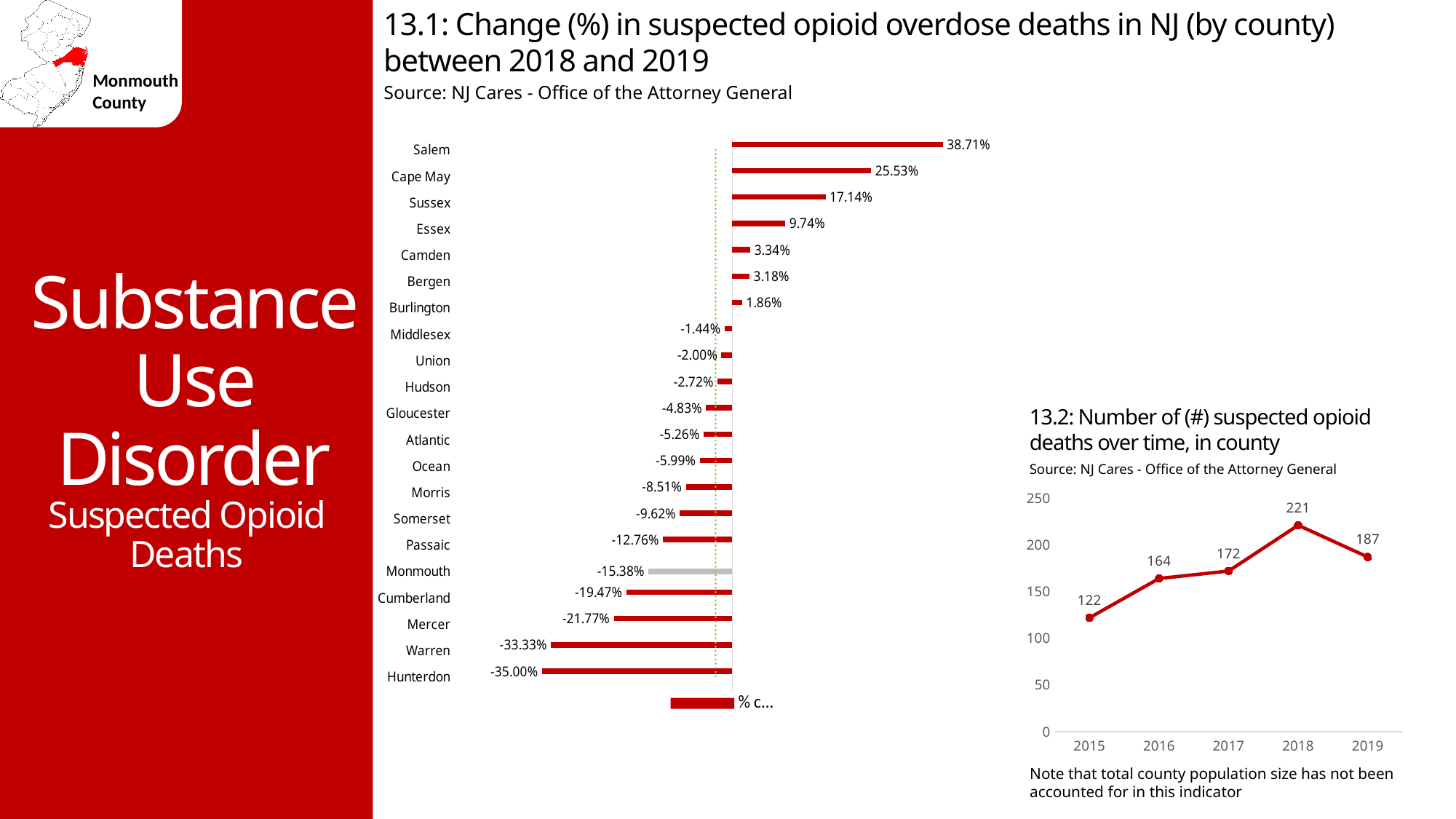
In chart 13.1, how many counties are shown? 21 In chart 13.1, which is larger, the value for Essex or the value for Camden? Essex What kind of chart is chart 13.1? Bar chart In chart 13.2, which year has the lowest number of suspected opioid deaths? 2015 In chart 13.1, which county has the highest percentage change? Salem In chart 13.1, what is the value for Cape May? 25.53% In chart 13.1 (Change (%) in suspected opioid overdose deaths in NJ by county), what is the value for Monmouth? -15.38% In chart 13.2, what is the difference between the values for 2018 and 2019? 34 In chart 13.1, what is the difference between the values for Salem and Cape May? 13.18% What kind of chart is chart 13.2? Line chart In chart 13.2 (Number of suspected opioid deaths over time, in county), what is the value for 2018? 221 In chart 13.1, which county has the lowest percentage change? Hunterdon